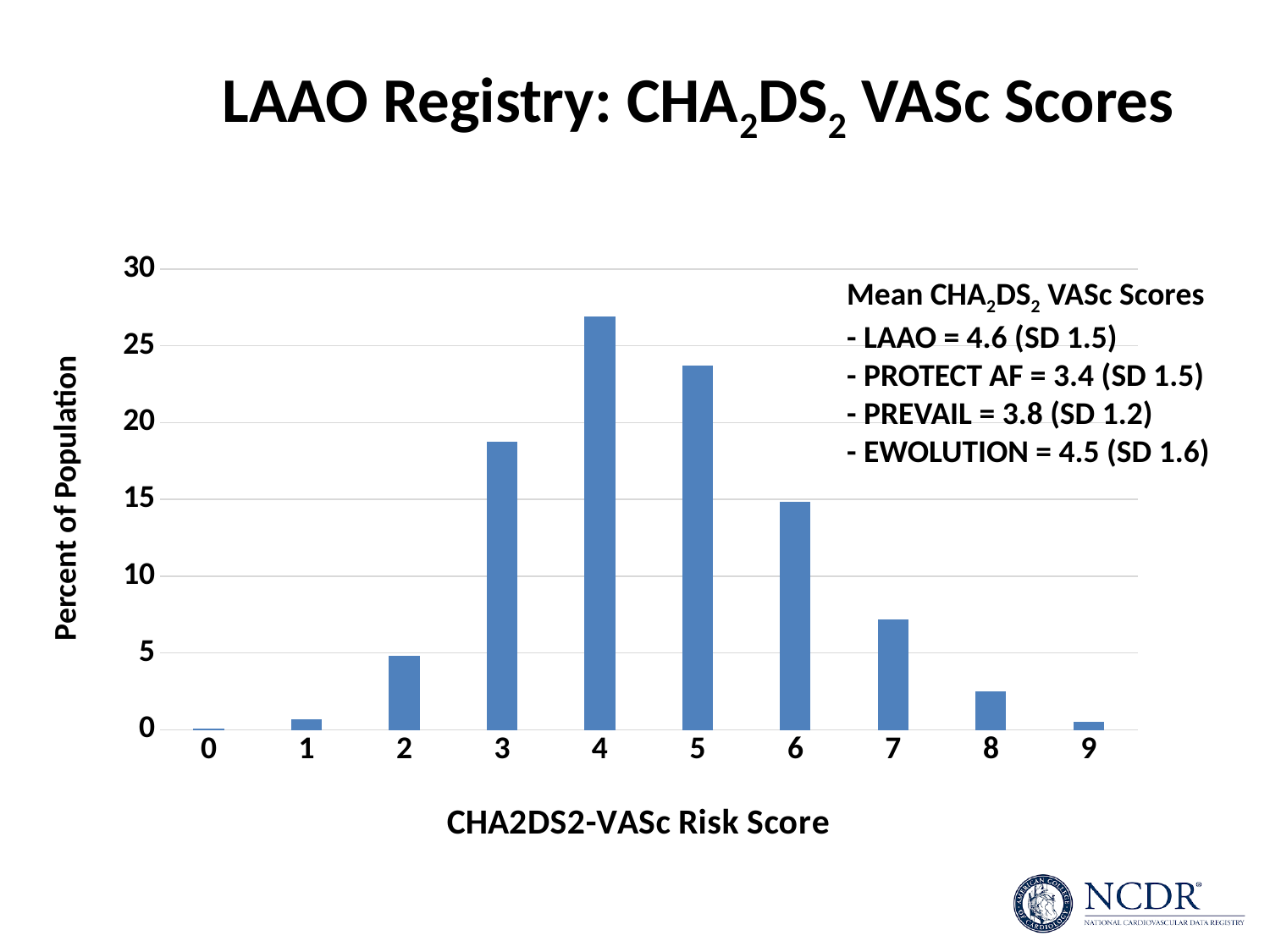
Which has a larger percent of population, risk score 2 or risk score 7? 7 What kind of chart is shown on the slide? bar chart Which CHA2DS2-VASc risk score has the lowest percent of population? 0 Is the percent of population for risk score 5 greater or less than 20? greater Is the percent of population for risk score 3 greater or less than 15? greater Which CHA2DS2-VASc risk score has the highest percent of population? 4 Is the percent of population for risk score 7 greater or less than 10? less What is the title of the y axis? Percent of Population Which has a larger percent of population, risk score 3 or risk score 5? 5 How many risk score categories are plotted on the x axis? 10